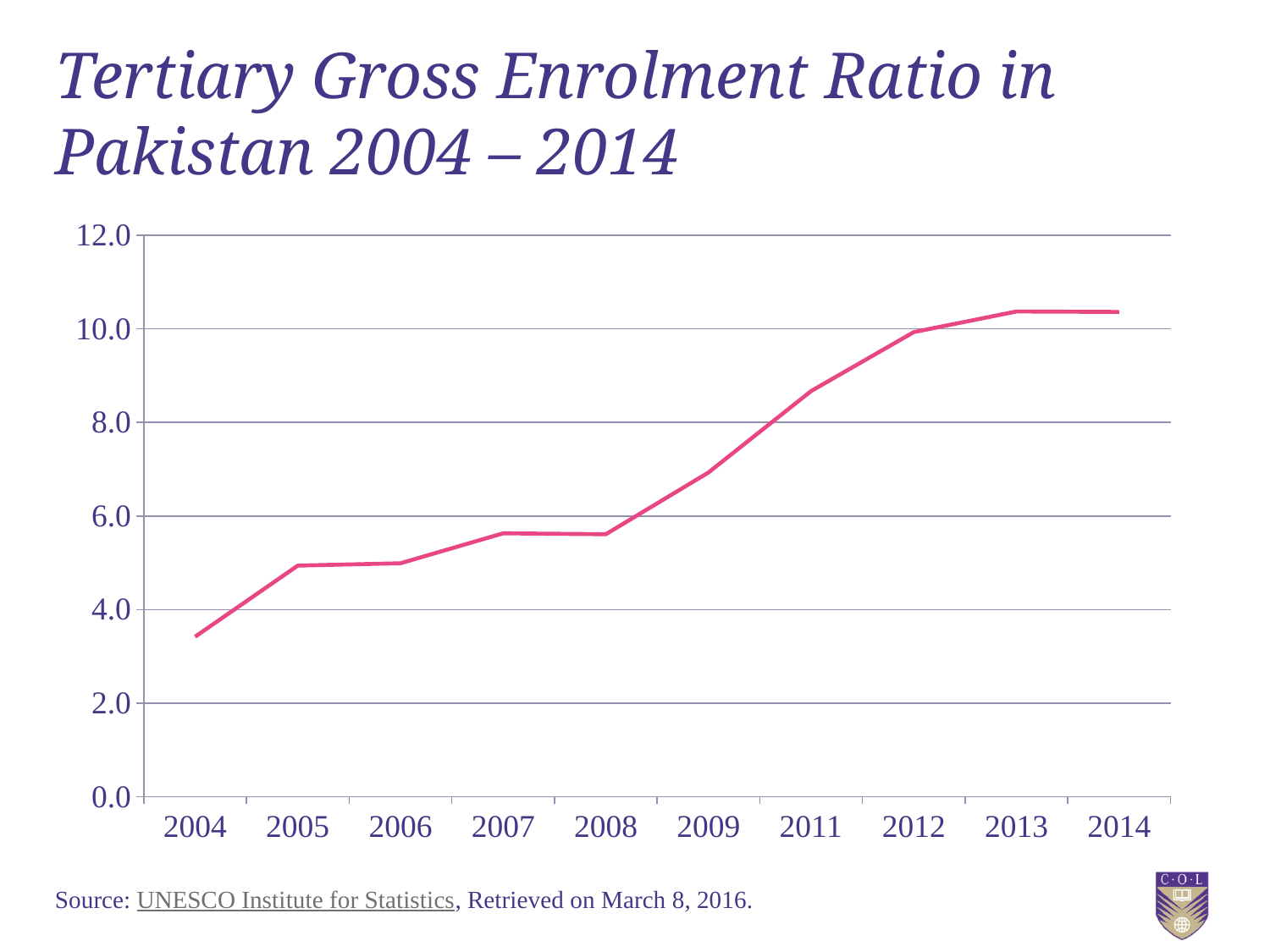
Is the value for 2004 greater or less than 4.0? less Which year has the lowest tertiary gross enrolment ratio? 2004 Is the value for 2009 greater or less than 6.0? greater Do the values generally rise or fall from 2004 to 2014? rise What kind of chart is shown on the slide? line chart What is the highest value shown on the y axis? 12.0 Which is larger, the value for 2005 or the value for 2009? 2009 How many years are plotted along the x axis? 10 What is the title of the chart? Tertiary Gross Enrolment Ratio in Pakistan 2004 – 2014 Is the value for 2011 greater or less than 8.0? greater